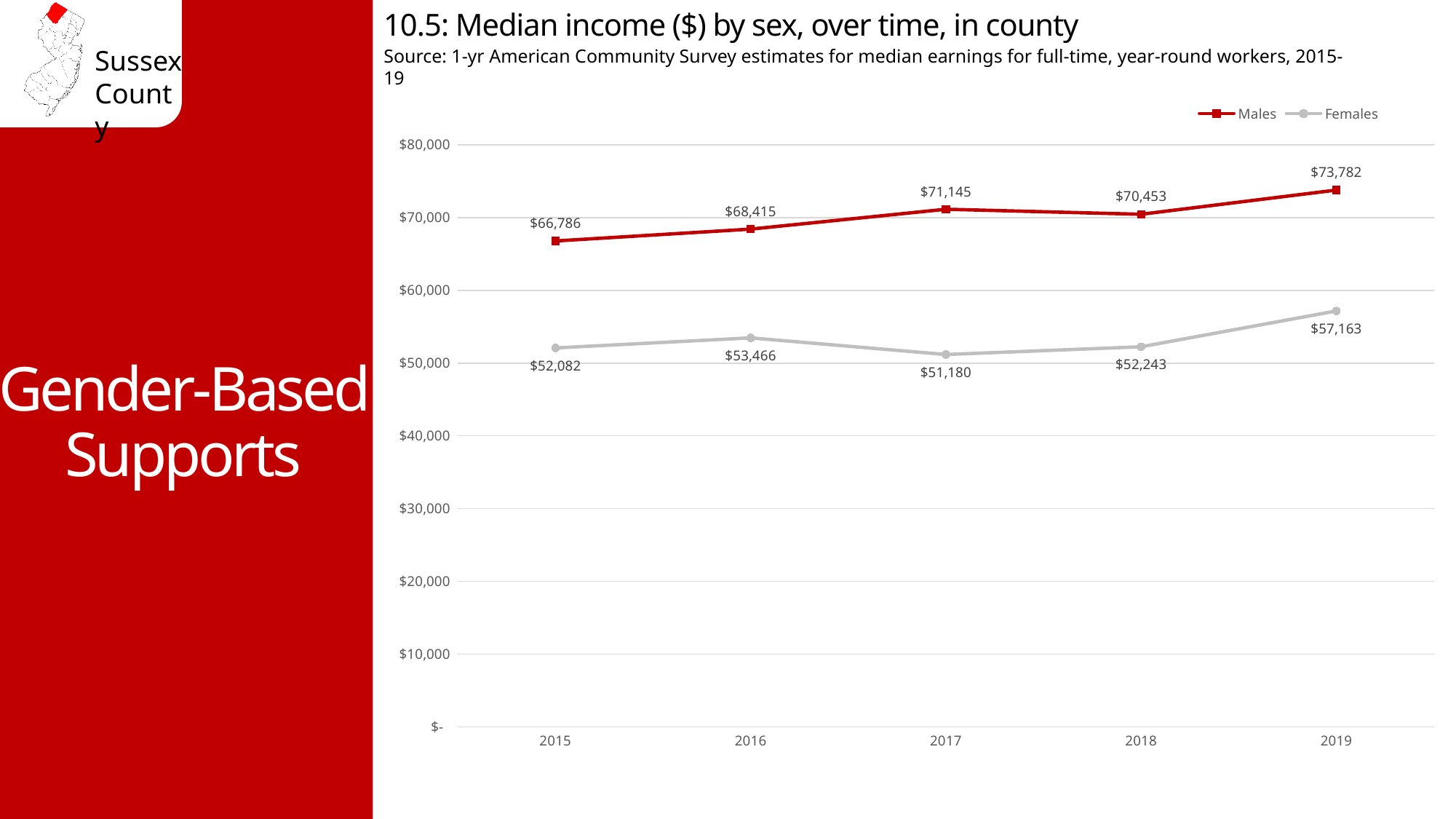
Which series had the higher median income in 2018, Males or Females? Males Did the median income for Males rise or fall from 2015 to 2016? rise In which year was the median income for Females lowest? 2017 What was the median income for Females in 2017? $51,180 What was the median income for Males in 2015? $66,786 How many series does the legend list? 2 What is the difference between the Males and Females median income in 2019? $16,619 What kind of chart is shown on the slide? line chart Is the median income for Females in 2016 greater or less than $60,000? less In which year was the median income for Males highest? 2019 What was the median income for Males in 2019? $73,782 How many years are shown on the x axis? 5